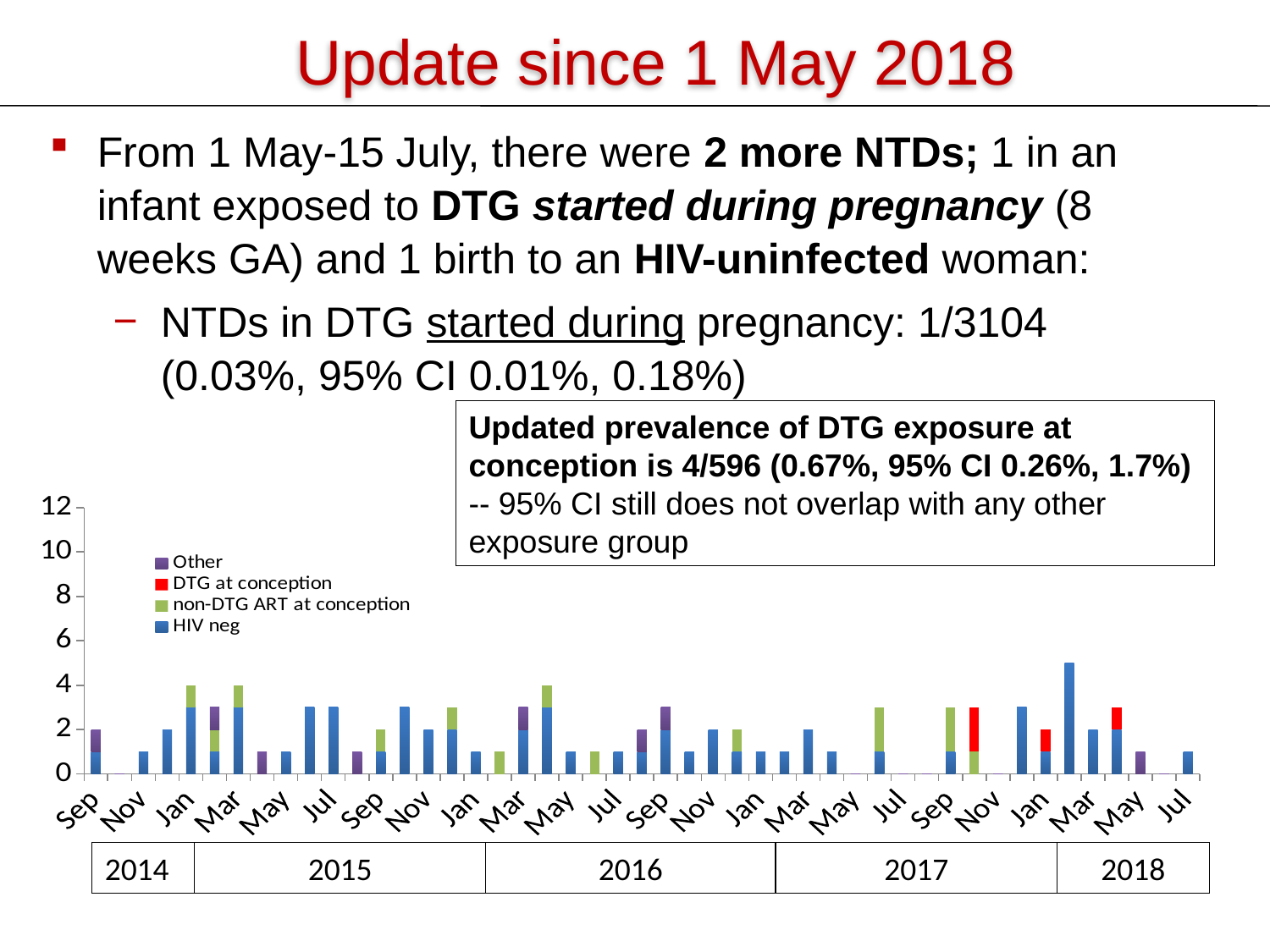
What kind of chart is shown on the slide? Stacked bar chart Which series is shown in blue in the chart? HIV neg Is the total for the tallest bar in the chart greater or less than 6? less How many years are labelled along the bottom of the chart? 5 How many series does the chart's legend list? 4 Is the total for the Jan 2015 bar greater or less than 2? greater What is the highest value shown on the chart's vertical axis? 12 In which month and year does the tallest bar in the chart occur? Feb 2018 Which series is shown in red in the chart? DTG at conception